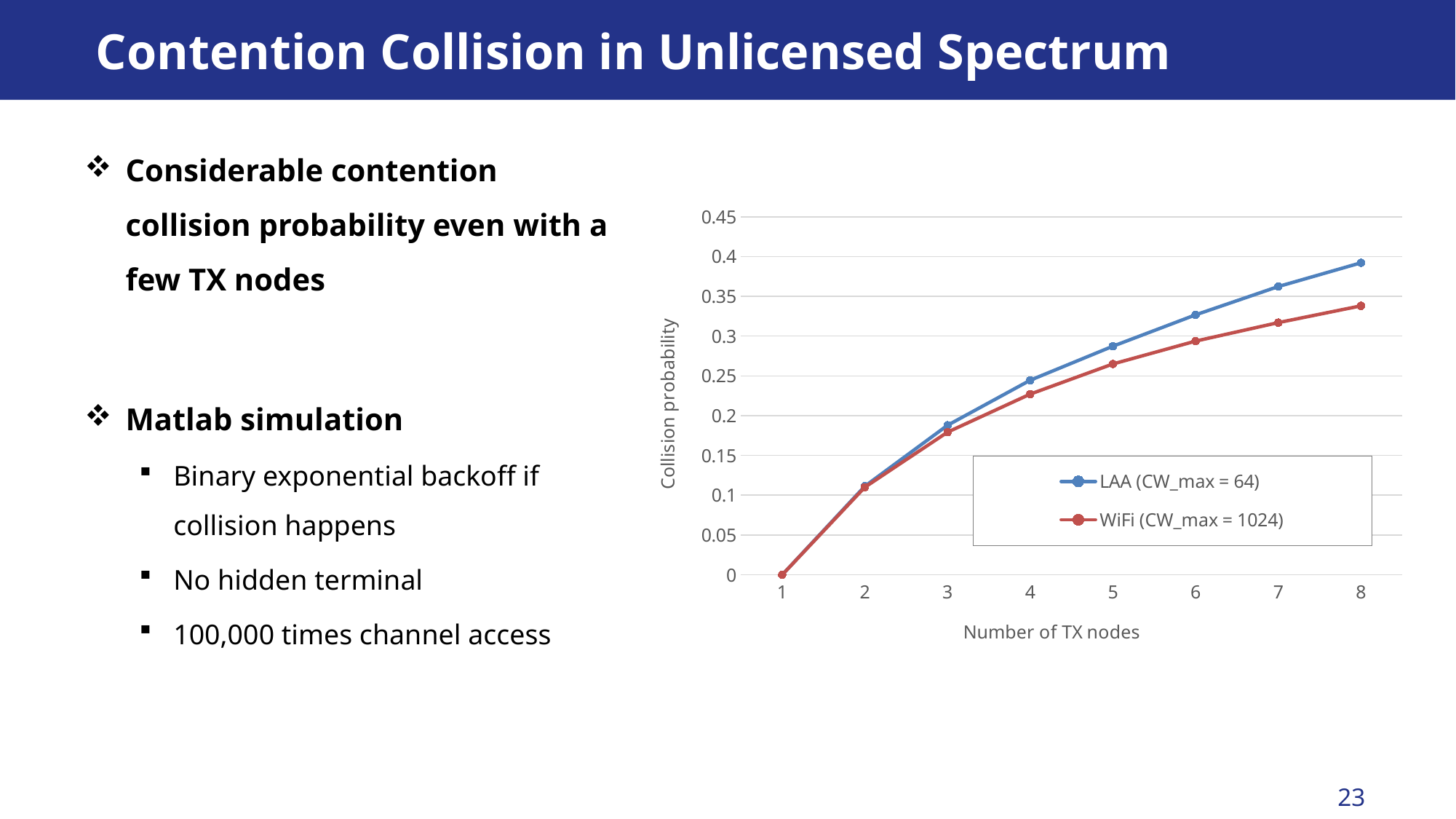
What is the label of the chart's y axis? Collision probability Does the collision probability for LAA (CW_max = 64) rise or fall as the number of TX nodes increases? rise What is the collision probability for WiFi (CW_max = 1024) at 1 TX node? 0 Is the collision probability for WiFi (CW_max = 1024) at 4 TX nodes greater or less than 0.25? less At 8 TX nodes, which series has the higher collision probability, LAA (CW_max = 64) or WiFi (CW_max = 1024)? LAA (CW_max = 64) Is the collision probability for LAA (CW_max = 64) at 8 TX nodes greater or less than 0.35? greater How many series does the chart legend list? 2 At which number of TX nodes is the collision probability for WiFi (CW_max = 1024) lowest? 1 Is the collision probability for WiFi (CW_max = 1024) at 8 TX nodes greater or less than 0.35? less What kind of chart is shown on the slide? line chart How many values of Number of TX nodes are plotted along the x axis? 8 At which number of TX nodes is the collision probability for LAA (CW_max = 64) highest? 8